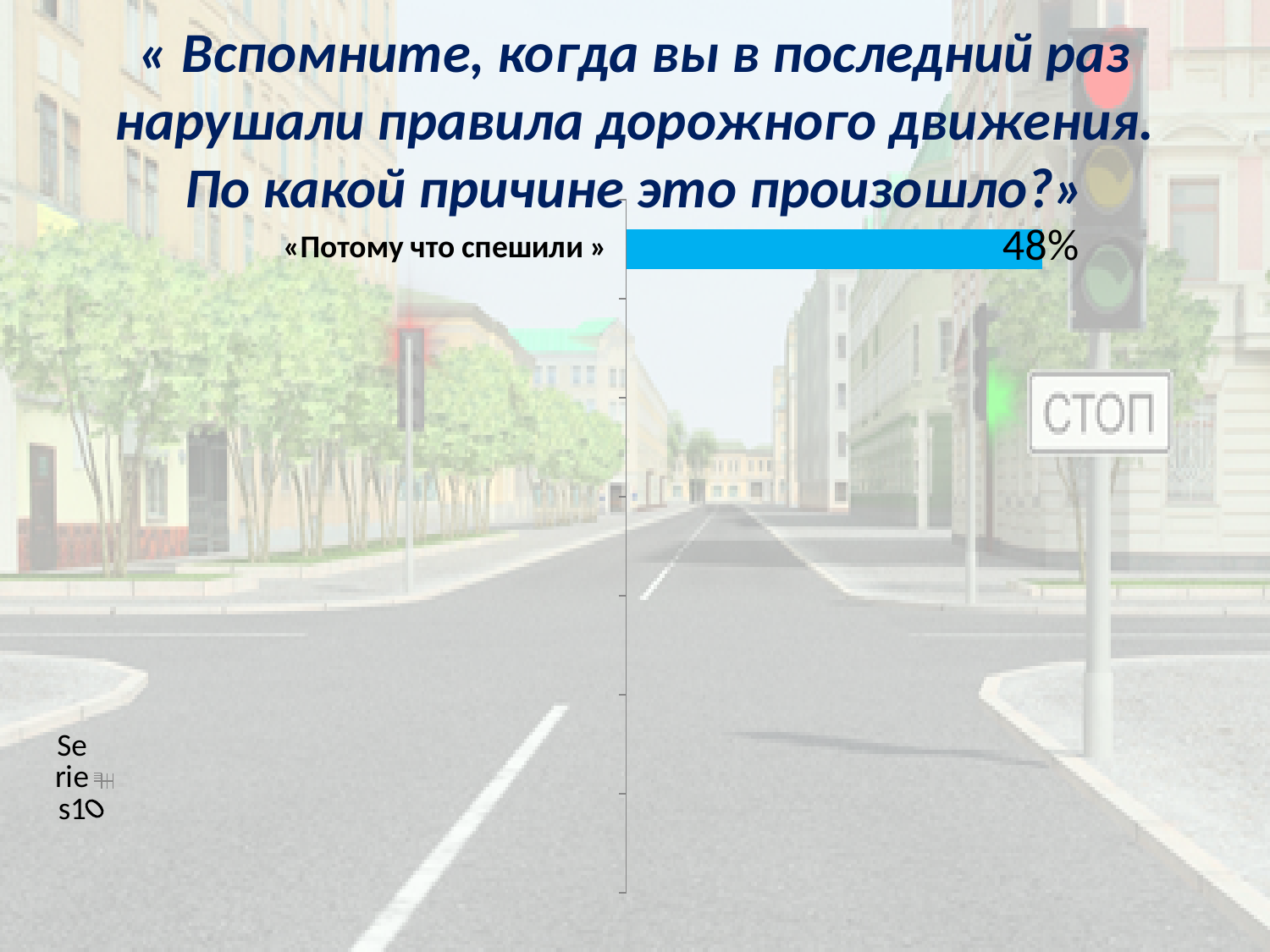
What value is shown for the bar labelled «Потому что спешили»? 48% How many bars with a readable category label are plotted on the chart? 1 What kind of chart is shown on the slide? bar chart What is the label of the category whose bar shows 48%? «Потому что спешили » What colour is the bar for «Потому что спешили»? blue